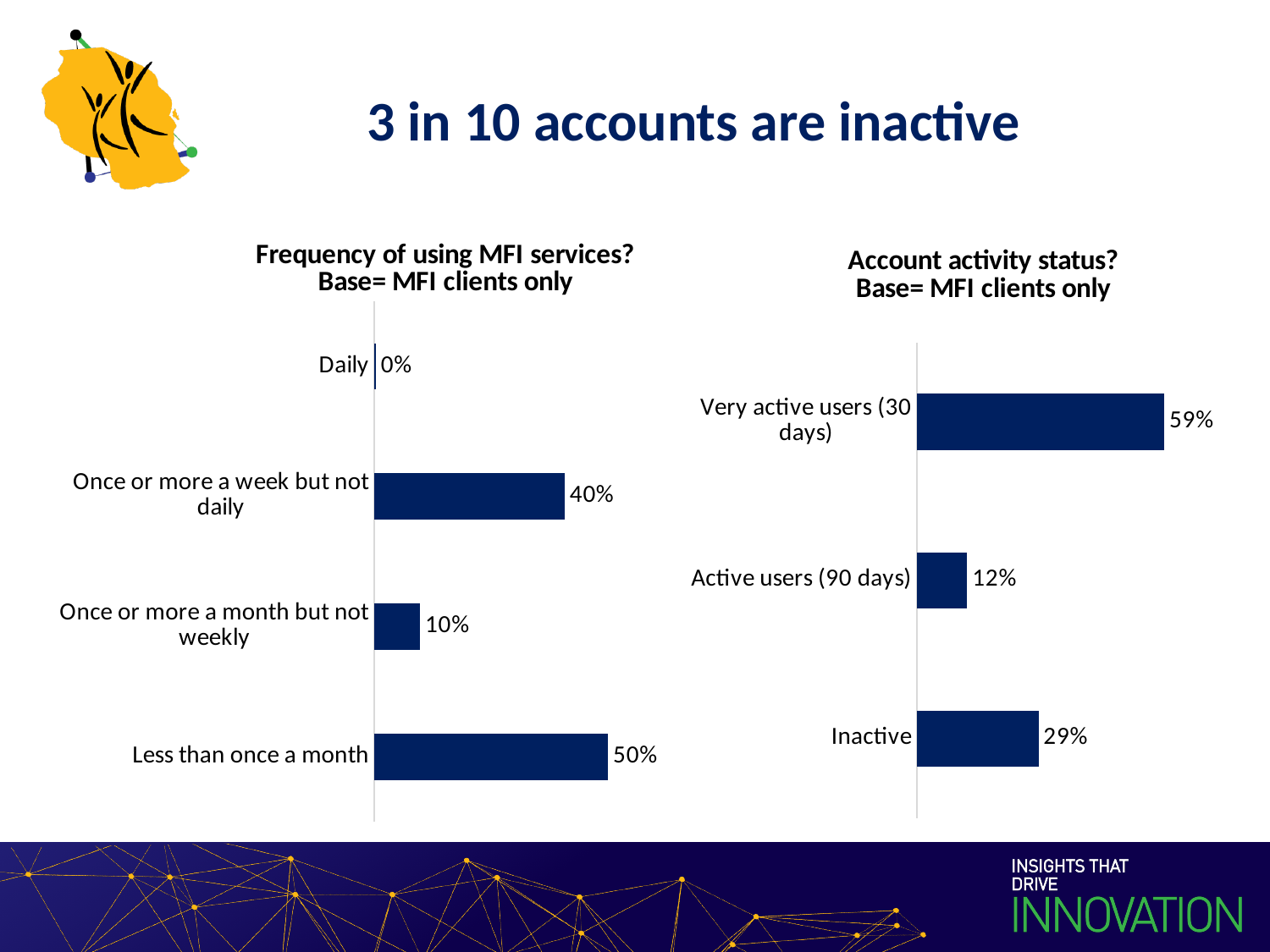
In the 'Account activity status?' chart, which category has the highest value? Very active users (30 days) In the 'Account activity status?' chart, what is the value for 'Active users (90 days)'? 12% In the 'Account activity status?' chart, what is the value for 'Inactive'? 29% In the 'Frequency of using MFI services?' chart, which category has the lowest value? Daily In the 'Frequency of using MFI services?' chart, what is the difference between 'Less than once a month' and 'Once or more a month but not weekly'? 40% In the 'Frequency of using MFI services?' chart, what is the value for 'Once or more a week but not daily'? 40% What kind of chart is the 'Account activity status?' chart? Bar chart In the 'Frequency of using MFI services?' chart, what is the value for 'Less than once a month'? 50% In the 'Frequency of using MFI services?' chart, which category has the highest value? Less than once a month In the 'Account activity status?' chart, what is the difference between 'Very active users (30 days)' and 'Inactive'? 30% In the 'Account activity status?' chart, which is larger: 'Inactive' or 'Active users (90 days)'? Inactive In the 'Frequency of using MFI services?' chart, how many categories are shown? 4